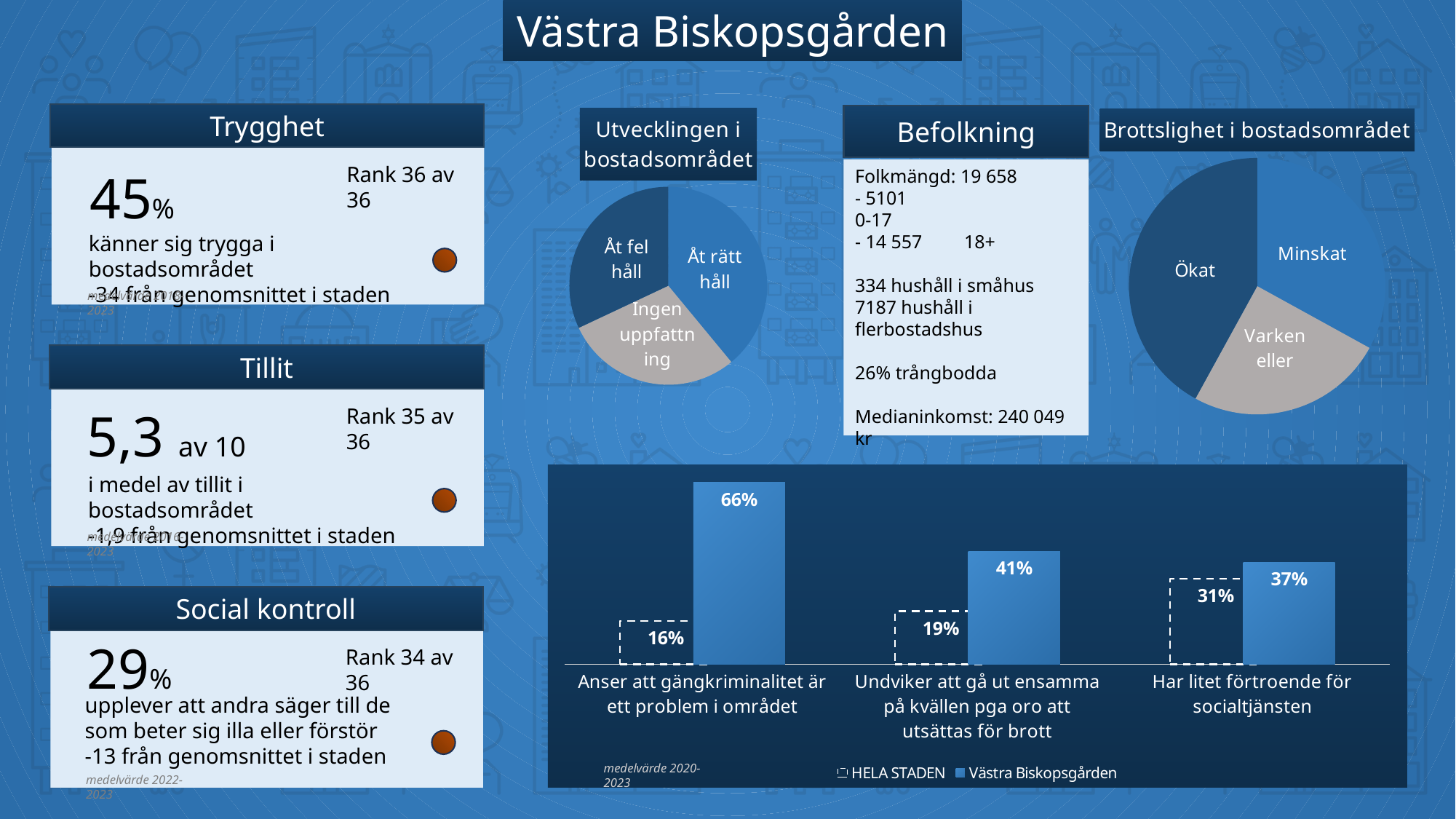
How many categories are shown in the bar chart at the bottom of the slide? 3 In the bar chart at the bottom of the slide, what is the value for Västra Biskopsgården for 'Anser att gängkriminalitet är ett problem i området'? 66% In the bar chart at the bottom of the slide, what is the difference between Västra Biskopsgården and HELA STADEN for 'Anser att gängkriminalitet är ett problem i området'? 50% In the bar chart at the bottom of the slide, what is the value for HELA STADEN for 'Har litet förtroende för socialtjänsten'? 31% In the pie chart titled 'Brottslighet i bostadsområdet', which slice is the largest? Ökat In the bar chart at the bottom of the slide, what is the value for HELA STADEN for 'Undviker att gå ut ensamma på kvällen pga oro att utsättas för brott'? 19% In the bar chart at the bottom of the slide, which category has the lowest value for HELA STADEN? Anser att gängkriminalitet är ett problem i området How many series does the legend of the bar chart at the bottom of the slide list? 2 In the pie chart titled 'Utvecklingen i bostadsområdet', which slice is the smallest? Ingen uppfattning In the bar chart at the bottom of the slide, which category has the highest value for Västra Biskopsgården? Anser att gängkriminalitet är ett problem i området In the bar chart at the bottom of the slide, what is the difference between Västra Biskopsgården and HELA STADEN for 'Har litet förtroende för socialtjänsten'? 6% In the bar chart at the bottom of the slide, which is larger for 'Undviker att gå ut ensamma på kvällen pga oro att utsättas för brott': HELA STADEN or Västra Biskopsgården? Västra Biskopsgården